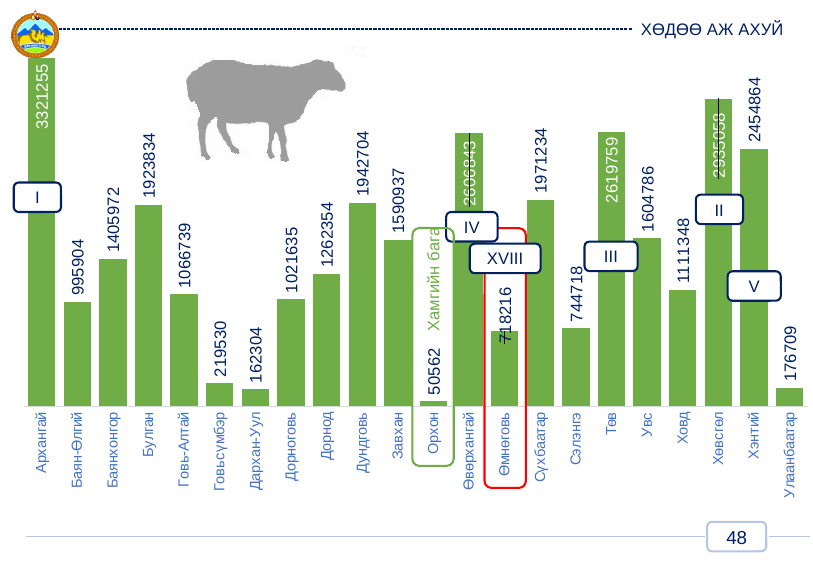
Which province has the highest value in the chart? Архангай How many provinces (categories) are shown on the x axis of the chart? 22 Which province has the lowest value in the chart? Орхон Which is larger, the value for Булган or the value for Дундговь? Дундговь What is the value shown for Улаанбаатар? 176709 What is the value shown for Архангай? 3321255 What type of chart is shown on the slide? bar chart Which rank label is placed on the bar for Архангай? I What is the value shown for Төв? 2619759 What is the difference between the values for Хэнтий and Сүхбаатар? 483630 What is the value shown for Орхон? 50562 What is the value shown for Өмнөговь? 718216